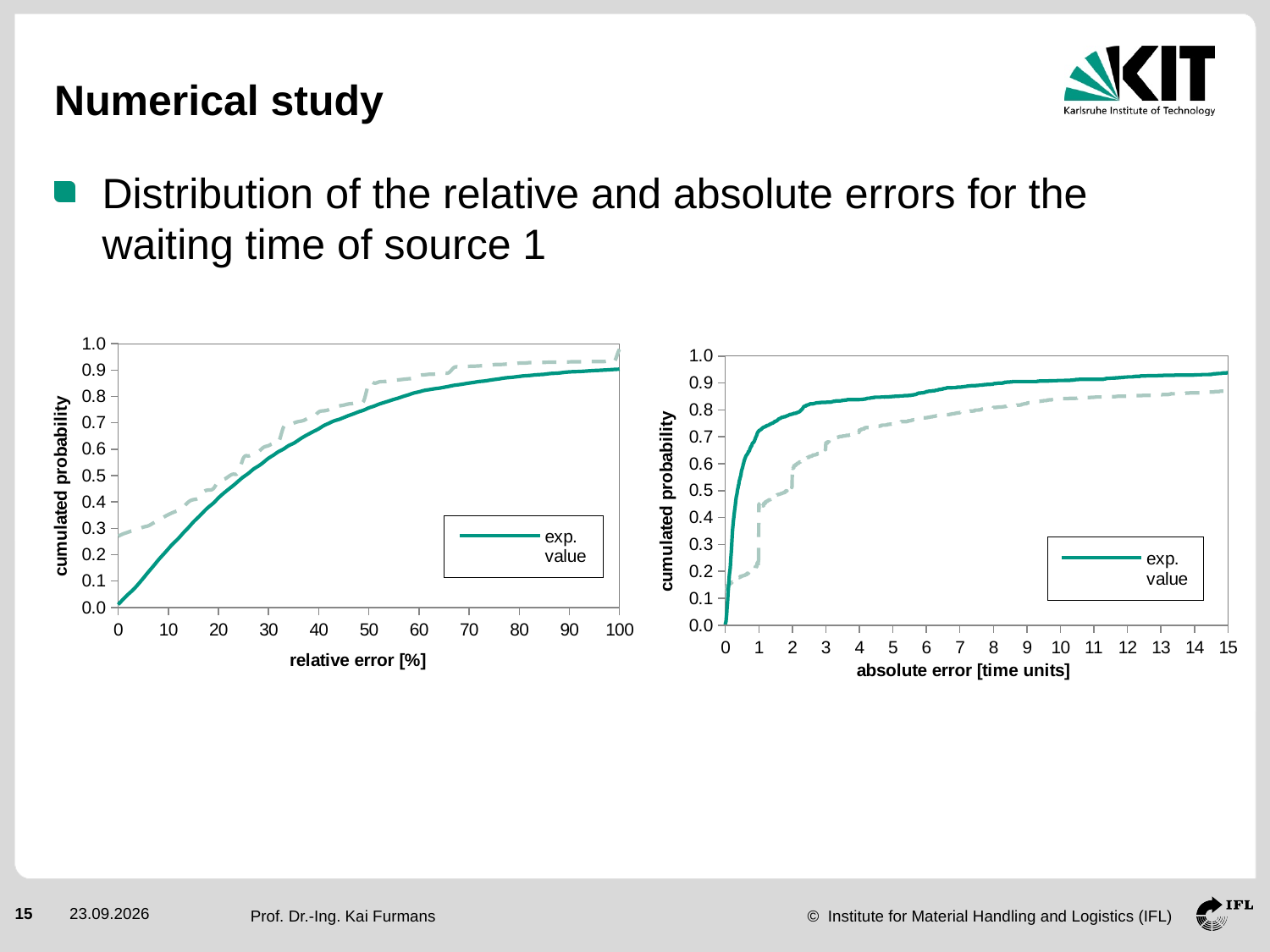
In the left chart, at a relative error of 10, which line has the higher cumulated probability, the solid 'exp. value' line or the dashed line? the dashed line In the right chart, what is the label of the y axis? cumulated probability In the left chart, is the value of the solid 'exp. value' line at a relative error of 10 greater or less than 0.3? less In the right chart, is the value of the solid 'exp. value' line at an absolute error of 15 greater or less than 0.9? greater In the left chart, what is the label of the x axis? relative error [%] In the left chart, is the value of the solid 'exp. value' line at a relative error of 100 greater or less than 0.8? greater In the left chart, does the solid 'exp. value' line rise or fall as the relative error increases? rise In the right chart, at an absolute error of 5, which line has the higher cumulated probability, the solid 'exp. value' line or the dashed line? the solid 'exp. value' line What kind of chart is the left chart (relative error)? line chart What kind of chart is the right chart (absolute error)? line chart In the right chart, does the solid 'exp. value' line rise or fall as the absolute error increases? rise